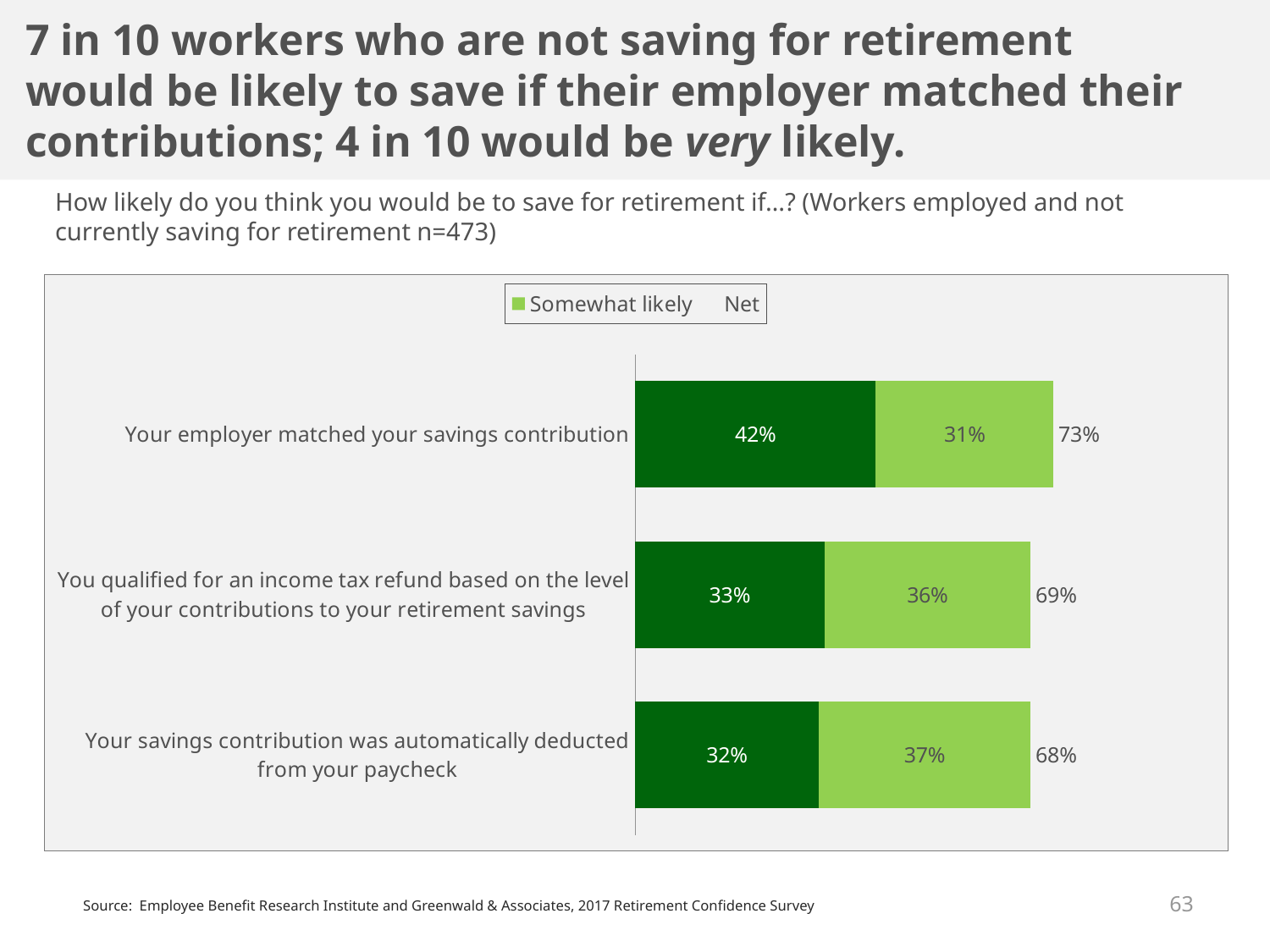
Which has a larger 'Somewhat likely' value: the income tax refund scenario or the employer match scenario? The income tax refund scenario What is the difference between the Net value for the employer match scenario and the Net value for the automatic paycheck deduction scenario? 5% Which scenario has the lowest Net value? Your savings contribution was automatically deducted from your paycheck How many entries does the chart legend list? 2 What type of chart is shown on the slide? Stacked bar chart How many scenarios (categories) are shown in the chart? 3 What is the total of the two segments in the bar for 'Your employer matched your savings contribution'? 73% What is the Net value for 'You qualified for an income tax refund based on the level of your contributions to your retirement savings'? 69% What value is shown in the dark green segment for 'Your savings contribution was automatically deducted from your paycheck'? 32% Which scenario has the highest Net value? Your employer matched your savings contribution What are the entries shown in the chart legend? Somewhat likely and Net What percentage of workers said they would be somewhat likely to save if their employer matched their savings contribution? 31%